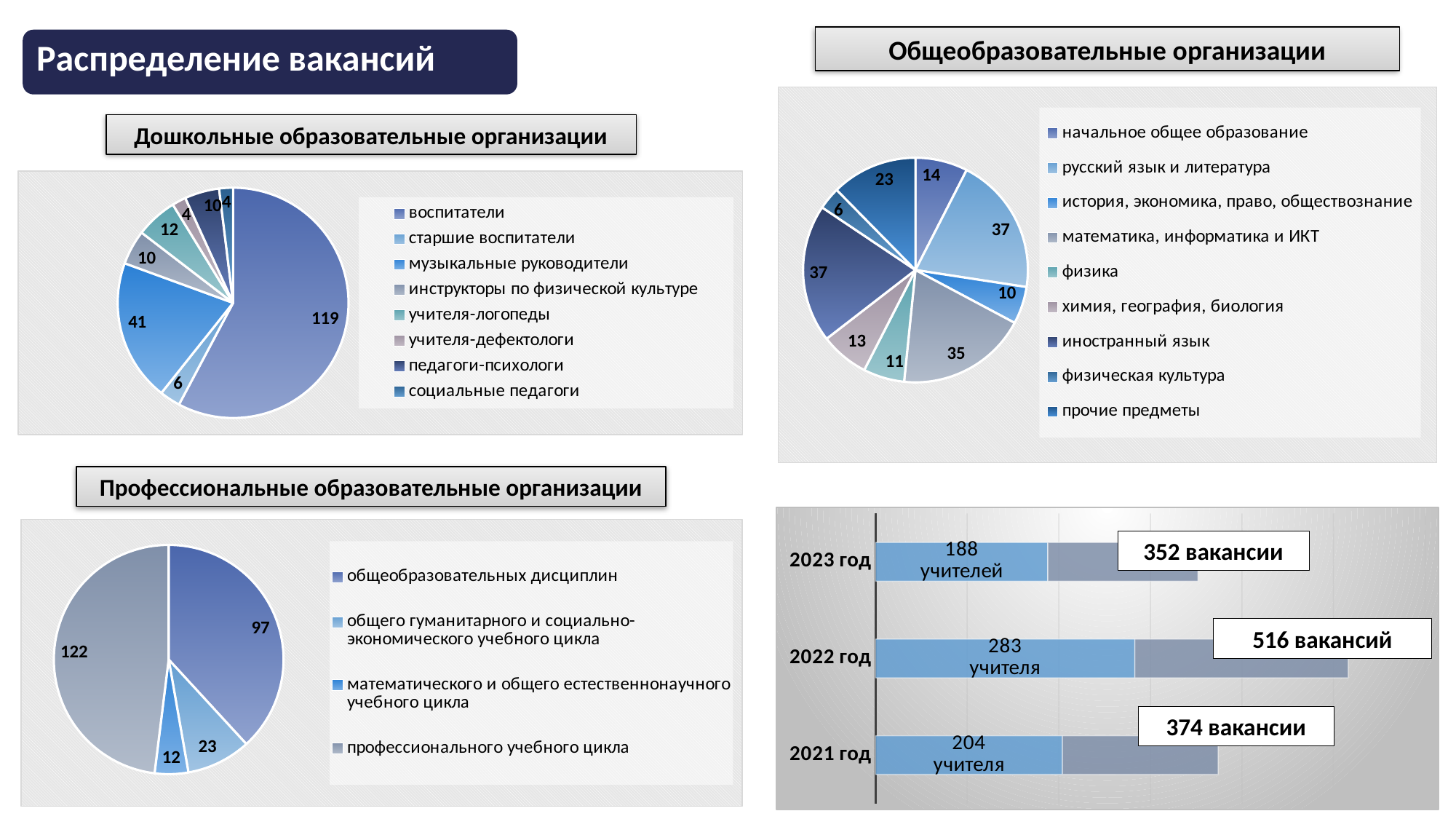
On the pie chart 'Дошкольные образовательные организации', what is the value for музыкальные руководители? 41 On the bar chart at the bottom right, how many teachers are shown for 2022 год? 283 учителя On the pie chart 'Общеобразовательные организации', which category has the smallest slice? физическая культура On the pie chart 'Общеобразовательные организации', what is the value for математика, информатика и ИКТ? 35 On the pie chart 'Дошкольные образовательные организации', which category has the largest slice? воспитатели On the pie chart 'Дошкольные образовательные организации', what is the value for воспитатели? 119 On the bar chart at the bottom right, how many vacancies are shown for 2021 год? 374 вакансии On the pie chart 'Дошкольные образовательные организации', how many categories does the legend list? 8 On the pie chart 'Профессиональные образовательные организации', what is the value for профессионального учебного цикла? 122 On the pie chart 'Общеобразовательные организации', what is the difference between прочие предметы and начальное общее образование? 9 What type of chart is shown at the bottom right of the slide? bar chart On the pie chart 'Профессиональные образовательные организации', which is larger: общеобразовательных дисциплин or общего гуманитарного и социально-экономического учебного цикла? общеобразовательных дисциплин